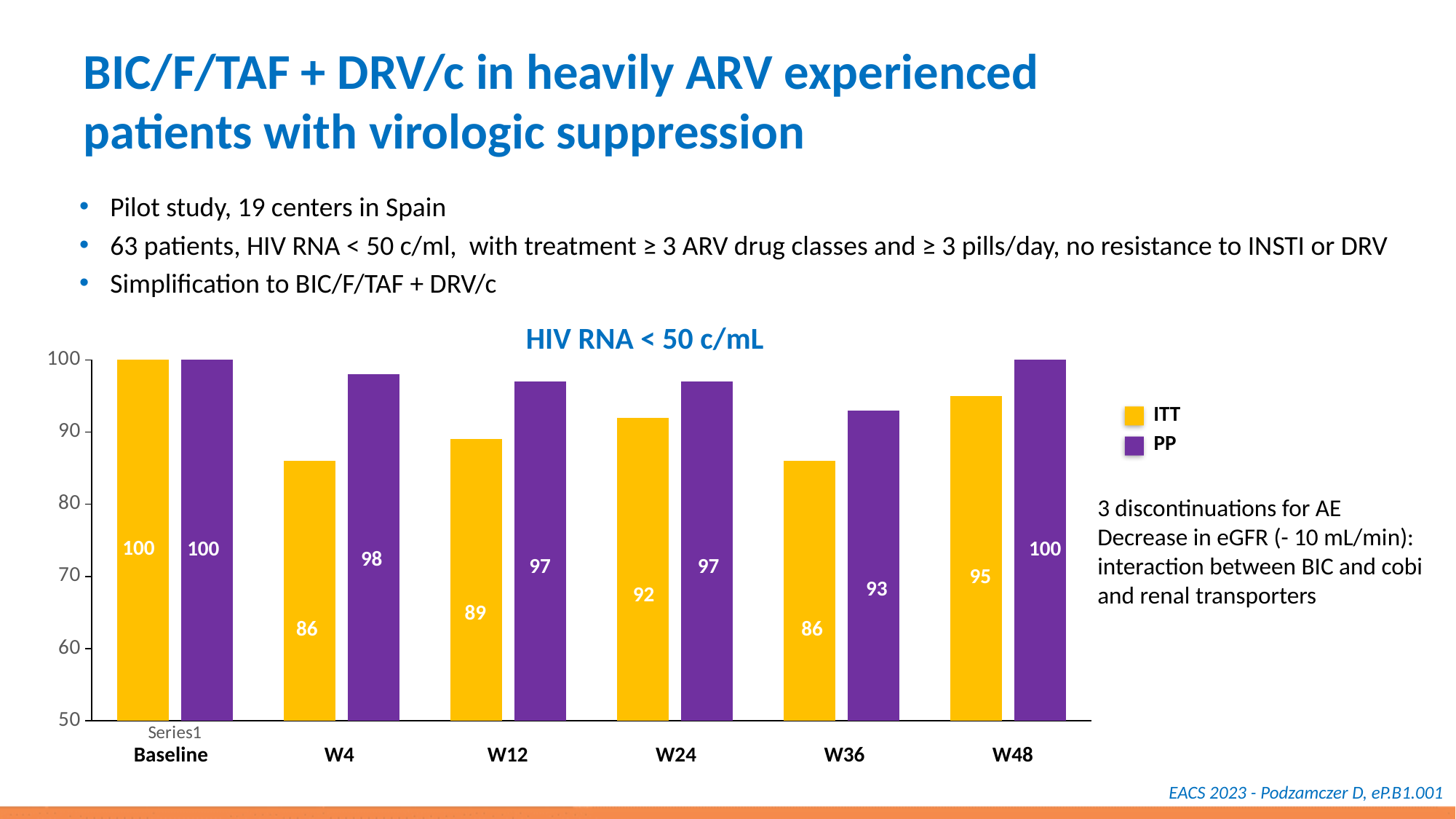
What is the ITT value at W4? 86 What is the PP value at W36? 93 At W24, which series has the higher value, ITT or PP? PP How many series does the legend list? 2 At which time point is the ITT value lowest? W4 and W36 Which colour represents the PP series? purple How many time points are shown on the x axis? 6 What is the difference between the ITT values at W48 and W36? 9 What is the ITT value at W48? 95 What kind of chart is shown? bar chart What is the title of the chart? HIV RNA < 50 c/mL What is the difference between the PP and ITT values at W4? 12